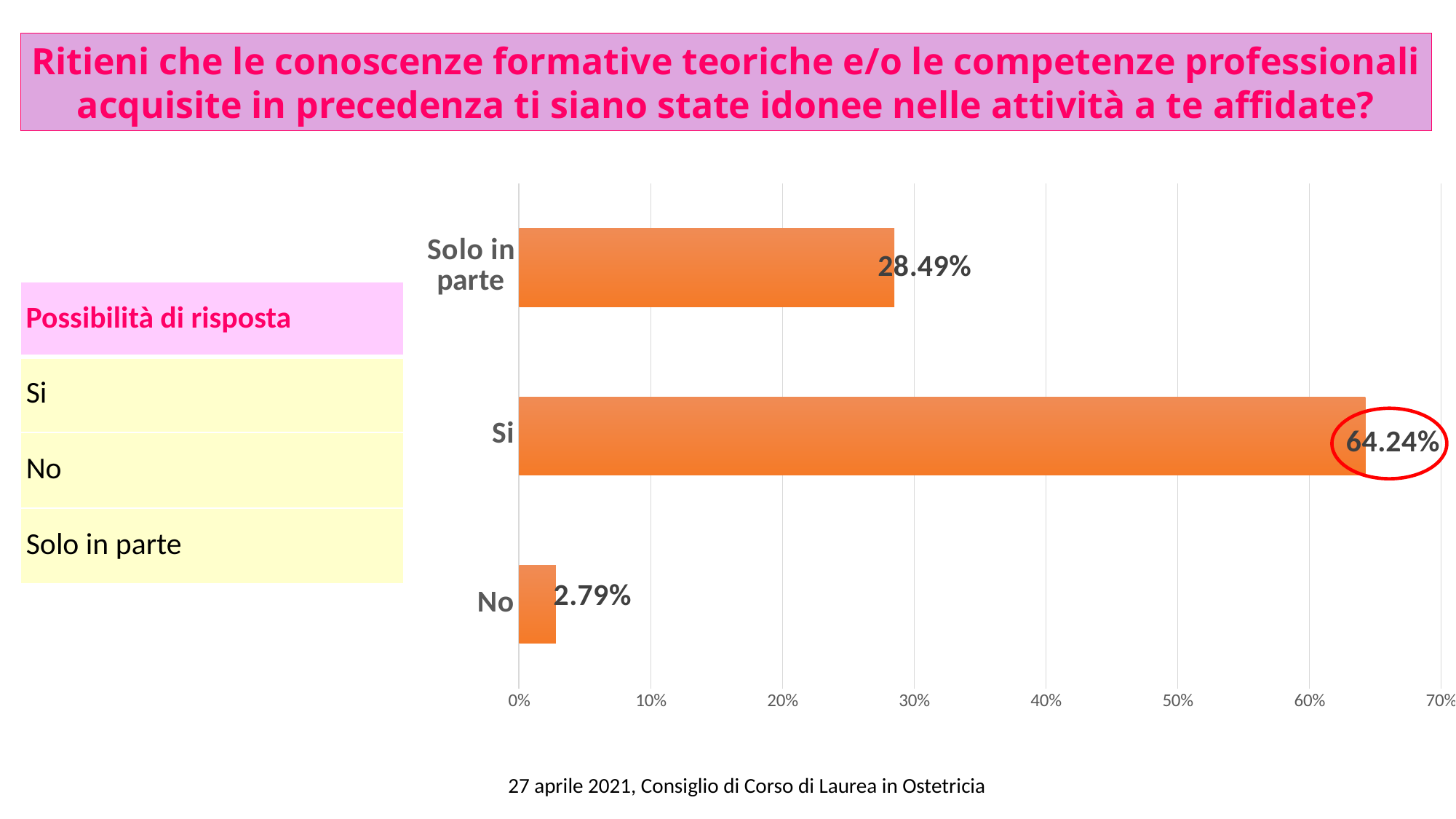
Which data label on the chart is circled in red? 64.24% What is the difference between the values for "Solo in parte" and "No"? 25.70% What is the value for "No"? 2.79% What kind of chart is shown on the slide? bar chart How many categories are shown in the chart? 3 Which category has the highest value? Si What is the value for "Solo in parte"? 28.49% Which category has the lowest value? No Which is larger, the value for "Solo in parte" or the value for "No"? Solo in parte What is the difference between the values for "Si" and "Solo in parte"? 35.75% Is the value for "Si" greater or less than 60%? greater What is the value for "Si"? 64.24%